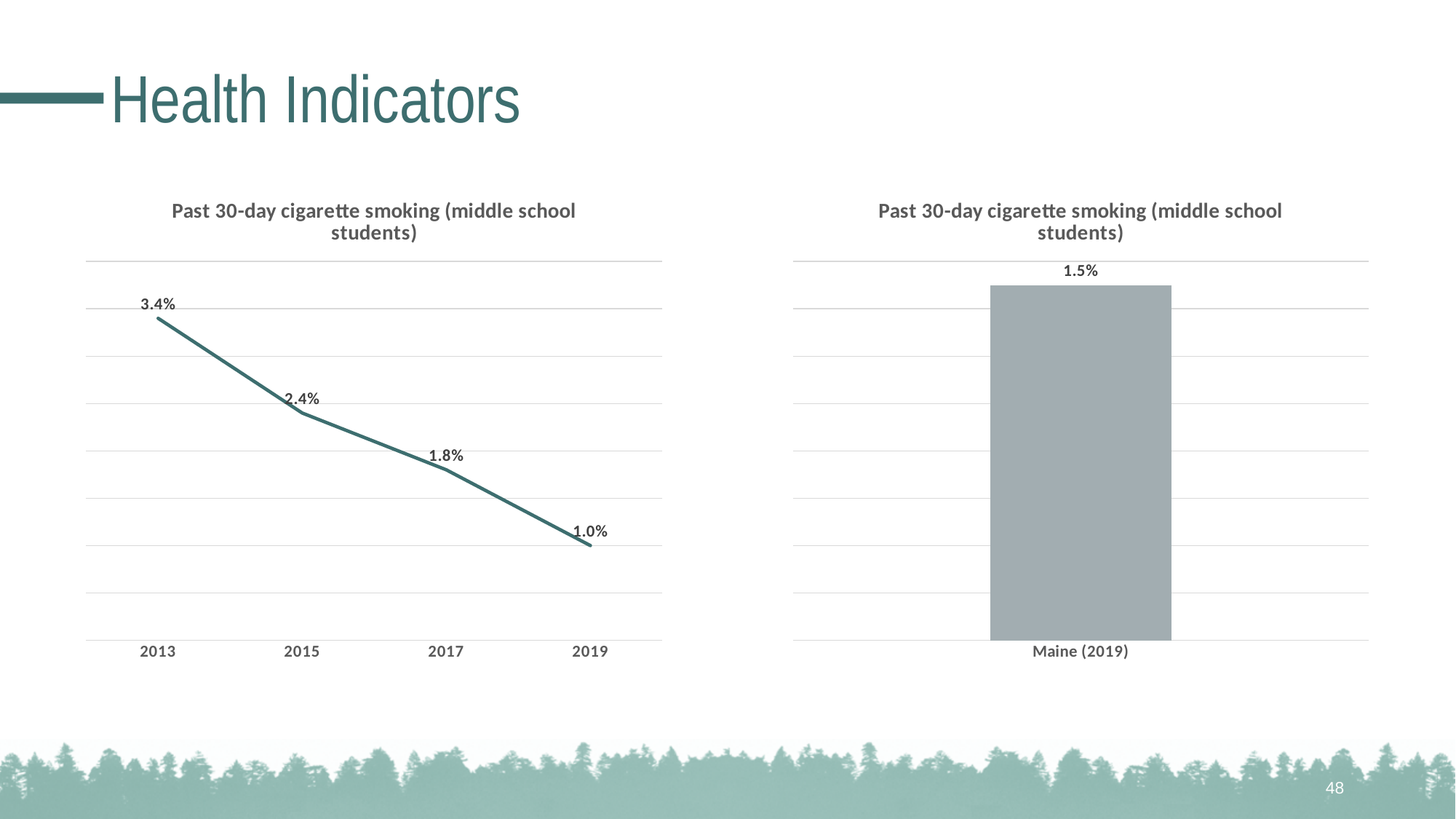
Which is larger: the 2019 value in the left chart or the Maine (2019) value in the right chart? Maine (2019) In the left chart, what is the difference between the 2013 and 2019 values? 2.4% In the left chart, which year has the lowest value? 2019 In the left chart, which year has the highest value? 2013 In the left chart, do the values rise or fall from 2013 to 2019? fall In the left chart, what is the value for 2013? 3.4% In the left chart, what is the value for 2015? 2.4% In the left chart, what is the value for 2019? 1.0% How many data points are plotted in the left chart? 4 In the left chart, what is the difference between the 2015 and 2017 values? 0.6% What kind of chart is the right chart? bar chart In the right chart, what is the value for Maine (2019)? 1.5%